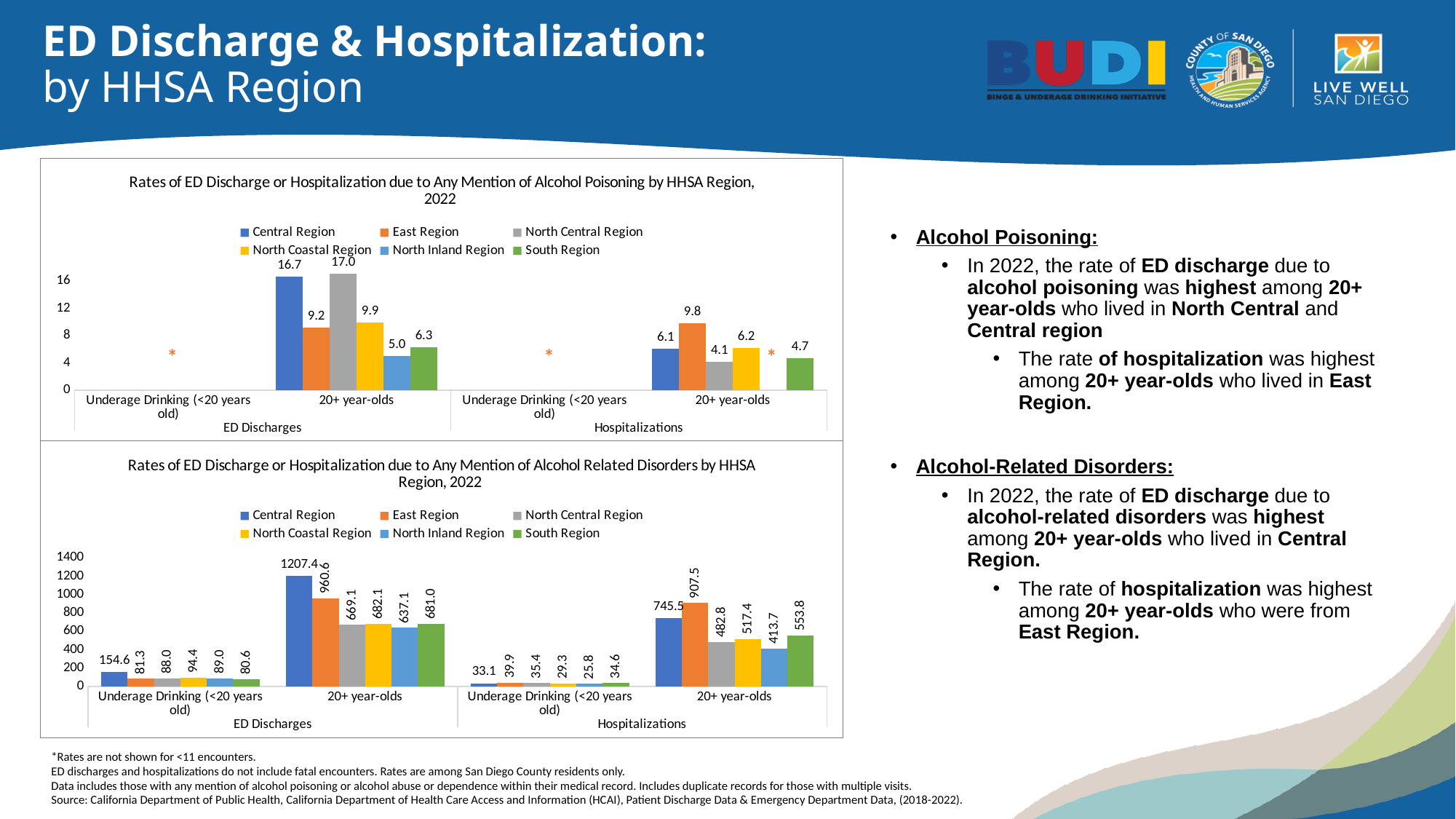
In the bottom chart (Alcohol Related Disorders), is the ED discharge rate for 20+ year-olds in the North Coastal Region greater or less than 800? less How many series does the legend of the top chart list? 6 In the top chart (Alcohol Poisoning), what is the difference between the ED discharge rates for 20+ year-olds in the Central Region and the East Region? 7.5 What kind of chart is the bottom chart (Alcohol Related Disorders)? Bar chart In the top chart (Alcohol Poisoning), which region has the lowest ED discharge rate among 20+ year-olds? North Inland Region In the top chart (Alcohol Poisoning), what is the ED discharge rate for 20+ year-olds in the North Central Region? 17.0 In the bottom chart (Alcohol Related Disorders), which is larger: the ED discharge rate for 20+ year-olds in the East Region or in the South Region? East Region In the top chart (Alcohol Poisoning), what is the hospitalization rate for 20+ year-olds in the East Region? 9.8 In the bottom chart (Alcohol Related Disorders), what is the hospitalization rate for underage drinking (<20 years old) in the North Inland Region? 25.8 In the bottom chart (Alcohol Related Disorders), what is the ED discharge rate for 20+ year-olds in the Central Region? 1207.4 In the bottom chart (Alcohol Related Disorders), which region has the highest hospitalization rate among 20+ year-olds? East Region In the bottom chart (Alcohol Related Disorders), what is the difference between the hospitalization rates for 20+ year-olds in the East Region and the North Inland Region? 493.8